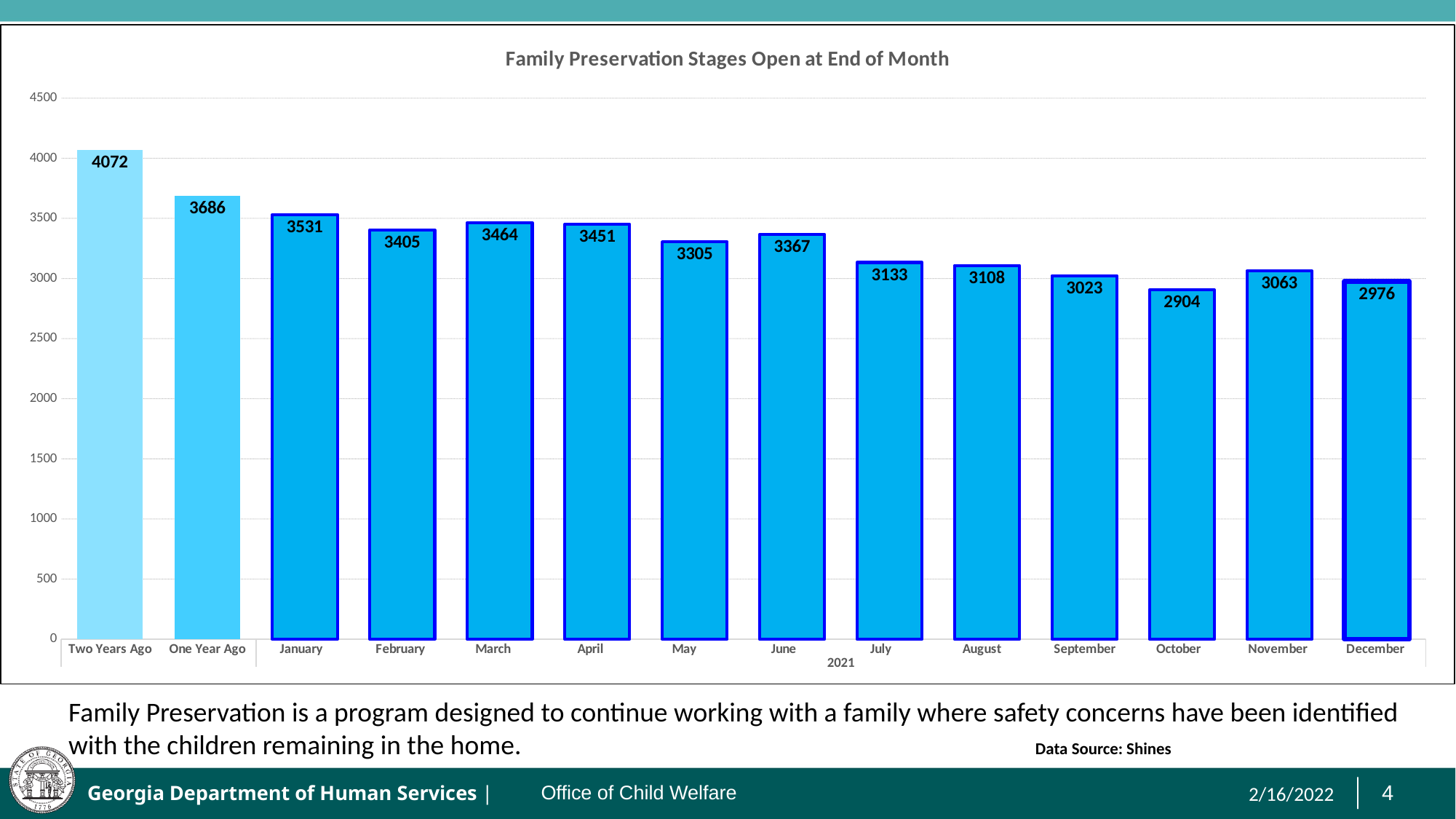
Which is larger, the value for May or the value for June? June Do the values generally rise or fall from January to December? fall Which category has the lowest value? October Is the value for September greater or less than 3500? less What is the title of the chart? Family Preservation Stages Open at End of Month What is the value for Two Years Ago? 4072 What is the value for October? 2904 What kind of chart is shown on the slide? bar chart How many bars are shown in the chart? 14 What is the value for March? 3464 What is the difference between the values for January and December? 555 Which category has the highest value? Two Years Ago